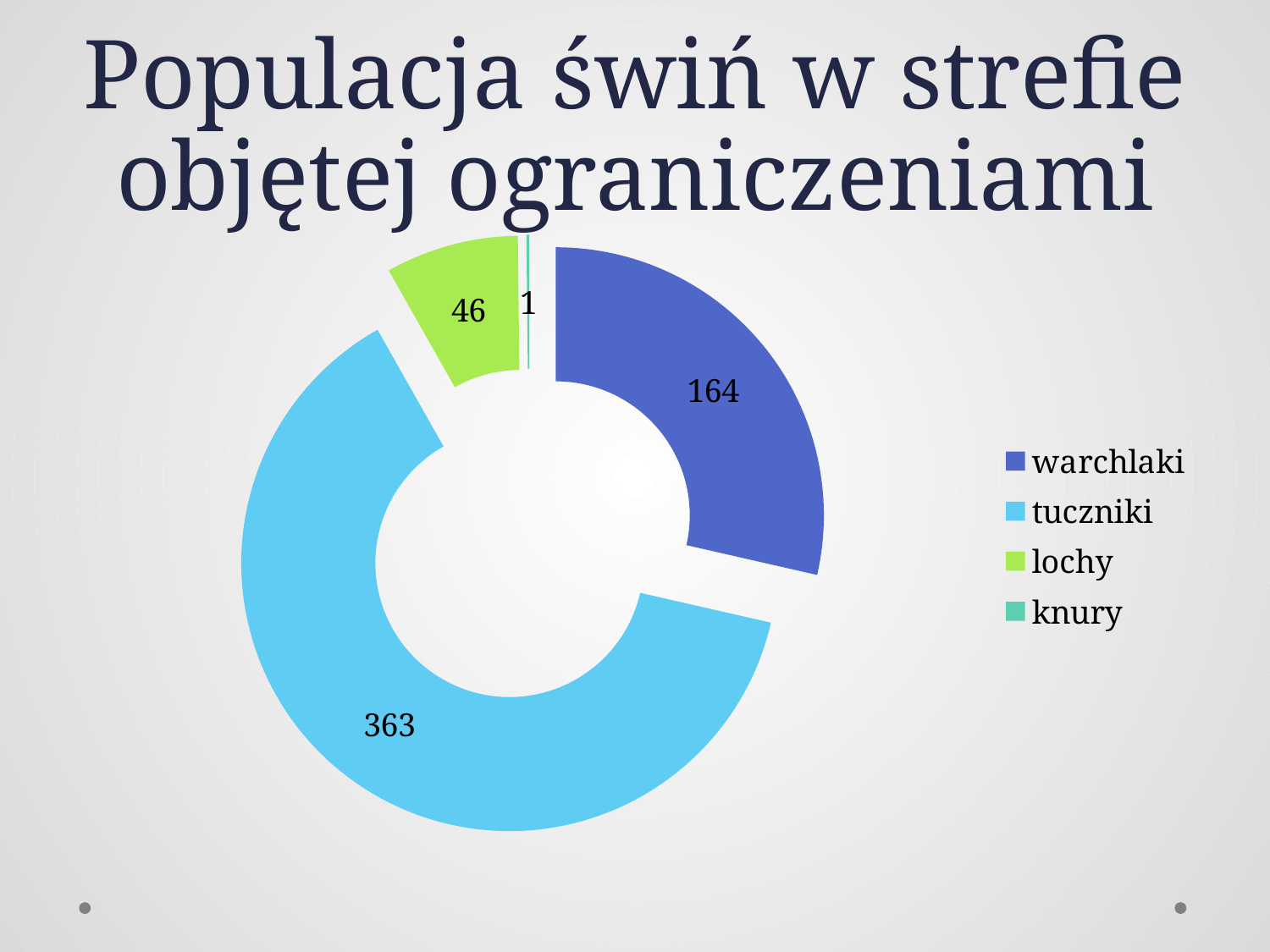
What is the value for tuczniki? 363 What is the difference between the values for tuczniki and warchlaki? 199 Which category has the lowest value? knury What is the value for warchlaki? 164 What is the value for lochy? 46 What kind of chart is shown on the slide? doughnut chart What is the value for knury? 1 What is the title of the chart? Populacja świń w strefie objętej ograniczeniami Which category has the highest value? tuczniki How many categories does the chart show? 4 Which is larger, the value for warchlaki or the value for lochy? warchlaki What is the total of all the values shown in the chart? 574